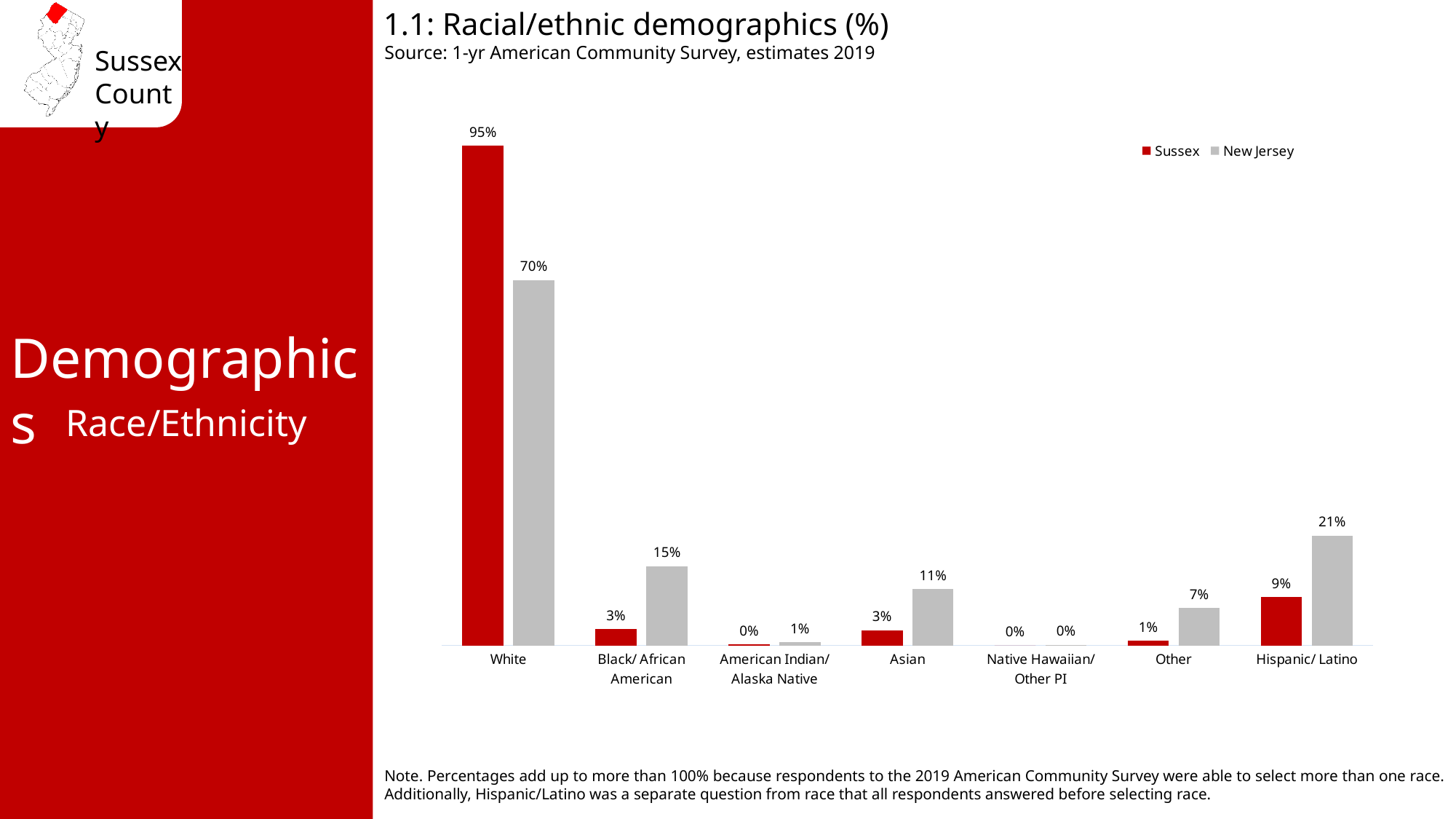
How many series does the legend list? 2 What is the difference between the New Jersey and Sussex values for Hispanic/ Latino? 12% Which category has the highest New Jersey value? White What is the New Jersey value for Hispanic/ Latino? 21% What is the difference between the Sussex and New Jersey values for White? 25% How many categories are shown on the x axis? 7 Which category has the highest Sussex value? White What is the Sussex value for Asian? 3% What kind of chart is shown? Bar chart What is the New Jersey value for Black/ African American? 15% What is the Sussex value for White? 95% Which is larger for Other: the Sussex value or the New Jersey value? New Jersey